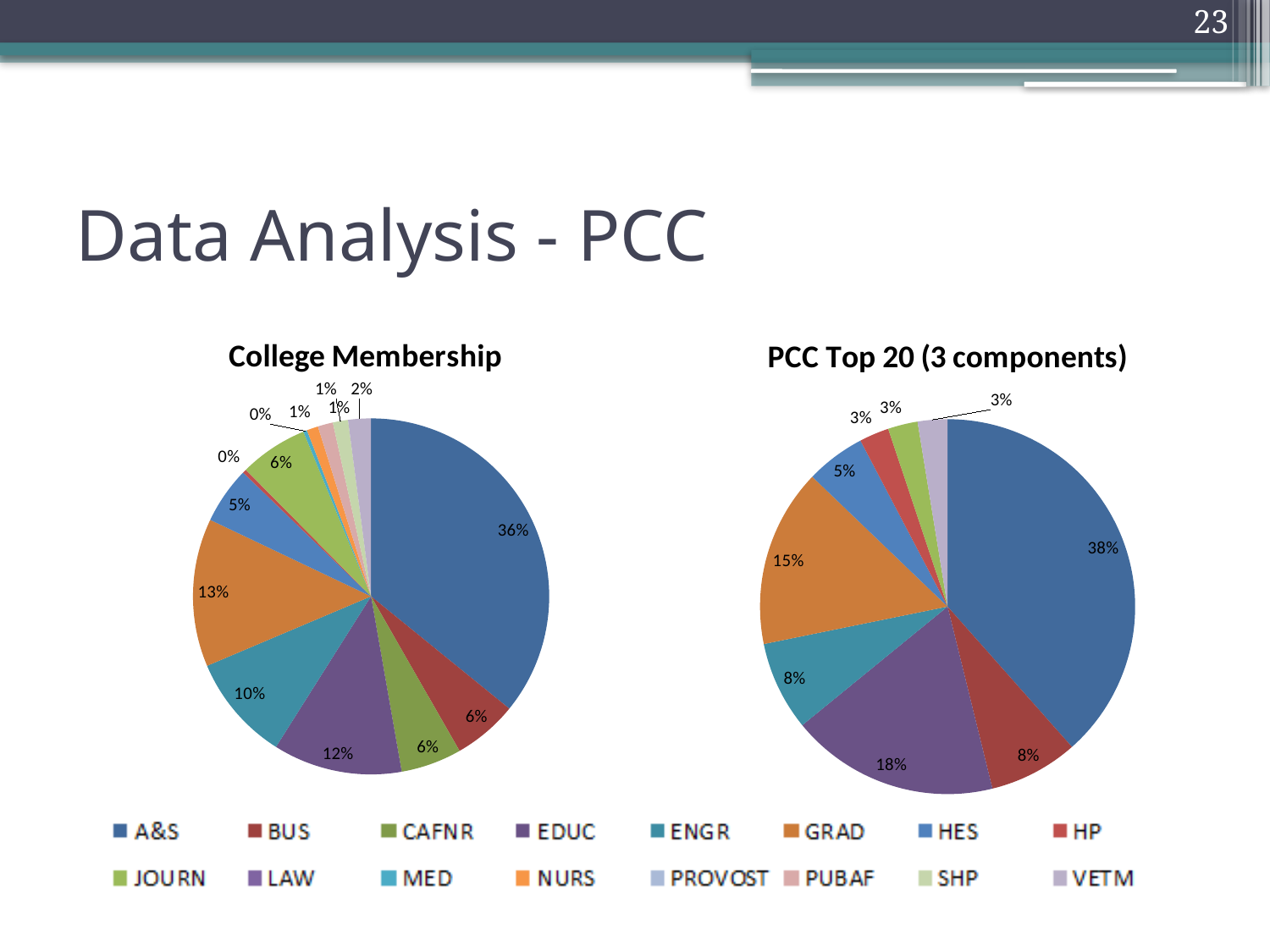
What type of chart is the College Membership chart? Pie chart In the College Membership chart, which is larger, the share for EDUC or the share for ENGR? EDUC In the PCC Top 20 (3 components) chart, what share does GRAD have? 15% In the College Membership chart, which college has the largest share? A&S How many entries does the shared legend list? 16 In the PCC Top 20 (3 components) chart, which college has the largest share? A&S In the PCC Top 20 (3 components) chart, what is the difference between the A&S share and the EDUC share? 20% In the College Membership chart, what share does ENGR have? 10% In the College Membership chart, what share does A&S have? 36% In the College Membership chart, what is the difference between the GRAD share and the HES share? 8% In the PCC Top 20 (3 components) chart, what share does EDUC have? 18% In the PCC Top 20 (3 components) chart, which is larger, the share for GRAD or the share for BUS? GRAD